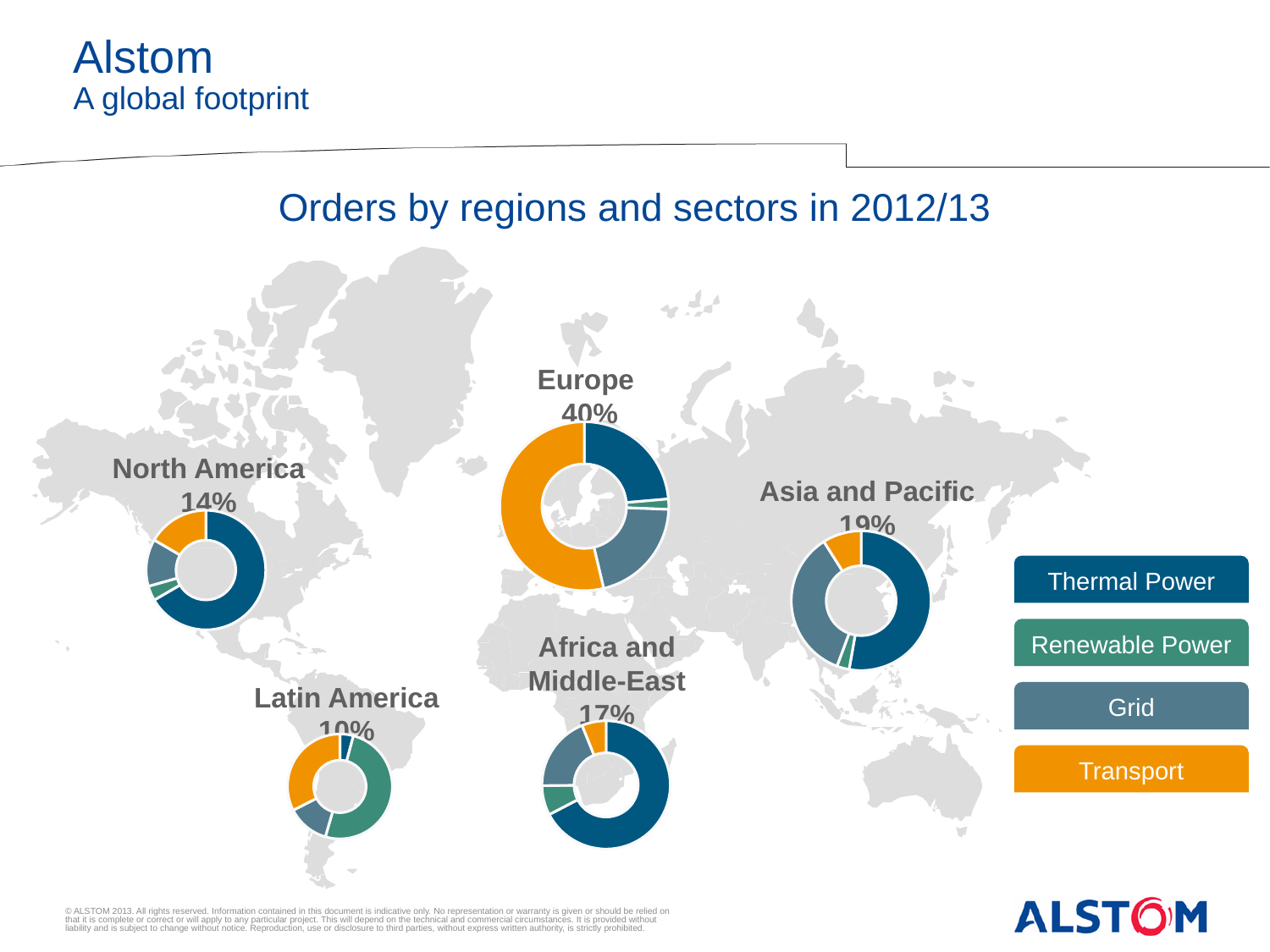
Which region has a larger share of orders, Africa and Middle-East or North America? Africa and Middle-East What kind of chart is used for each region? Donut (pie) chart How many sectors does the legend list? 4 What is the difference between the Europe share and the North America share of orders? 26% What share of orders does the Africa and Middle-East chart show? 17% Which region has the highest share of orders in 2012/13? Europe In the Europe chart, which sector takes the largest slice? Transport Which region has the lowest share of orders in 2012/13? Latin America Which colour represents Thermal Power in the legend? Dark blue What share of orders does the Europe chart show? 40% What share of orders does the North America chart show? 14% How many regional charts are shown on the slide? 5